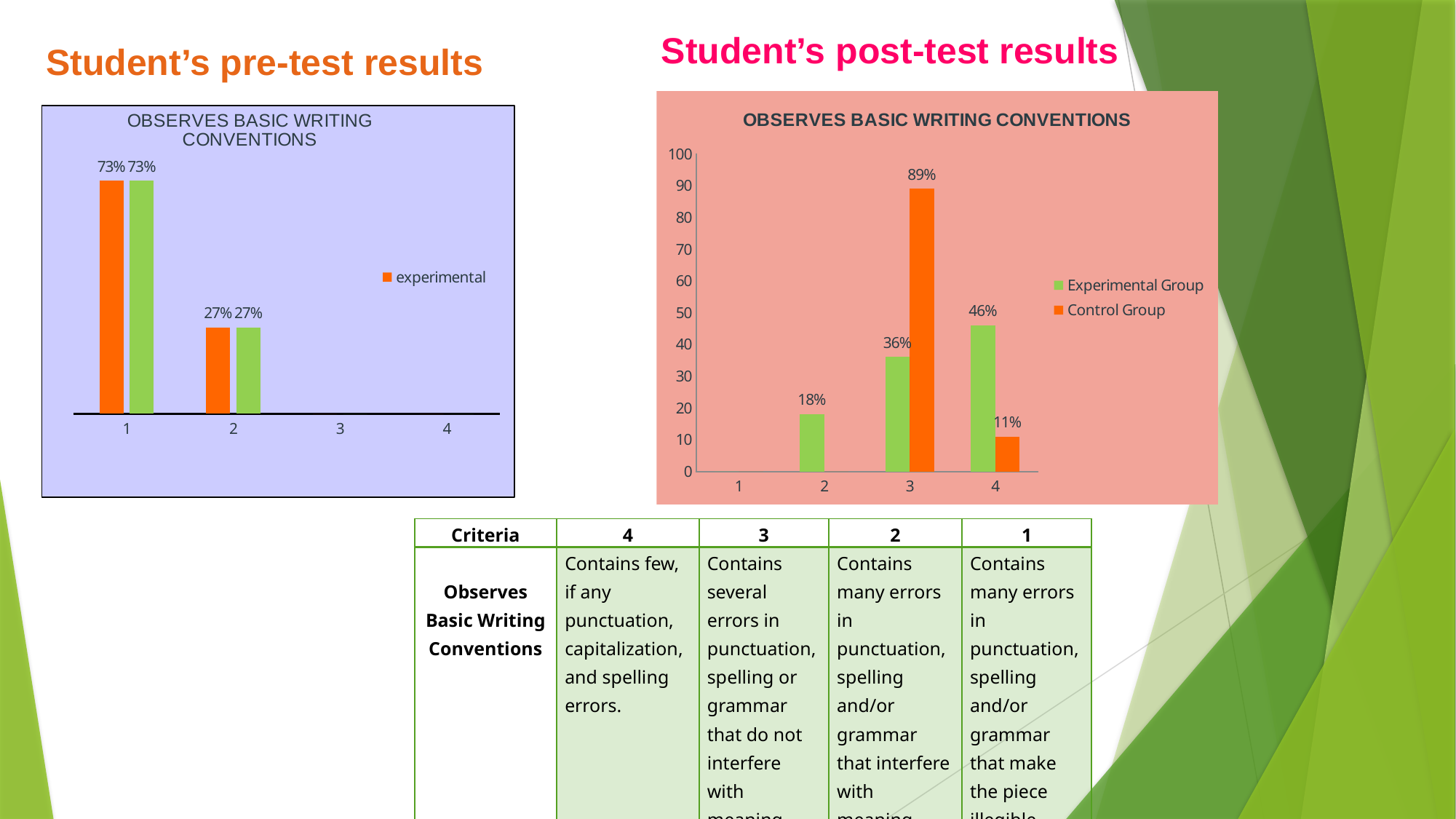
In the pre-test results chart, what is the value for the experimental series at category 2? 27% In the post-test results chart, which category has the highest Experimental Group value? 4 In the post-test results chart, do the Experimental Group values rise or fall from category 2 to category 4? rise In the post-test results chart, at category 4, which series has the larger value, Experimental Group or Control Group? Experimental Group How many series does the legend of the post-test results chart list? 2 In the post-test results chart, what is the value for the Control Group at category 4? 11% In the post-test results chart, what is the value for the Control Group at category 3? 89% In the post-test results chart, what is the value for the Experimental Group at category 2? 18% In the post-test results chart, what is the value for the Experimental Group at category 4? 46% In the pre-test results chart, what is the value for the experimental series at category 1? 73% In the post-test results chart, what is the difference between the Control Group and Experimental Group values at category 3? 53% What kind of chart is the pre-test results chart? bar chart